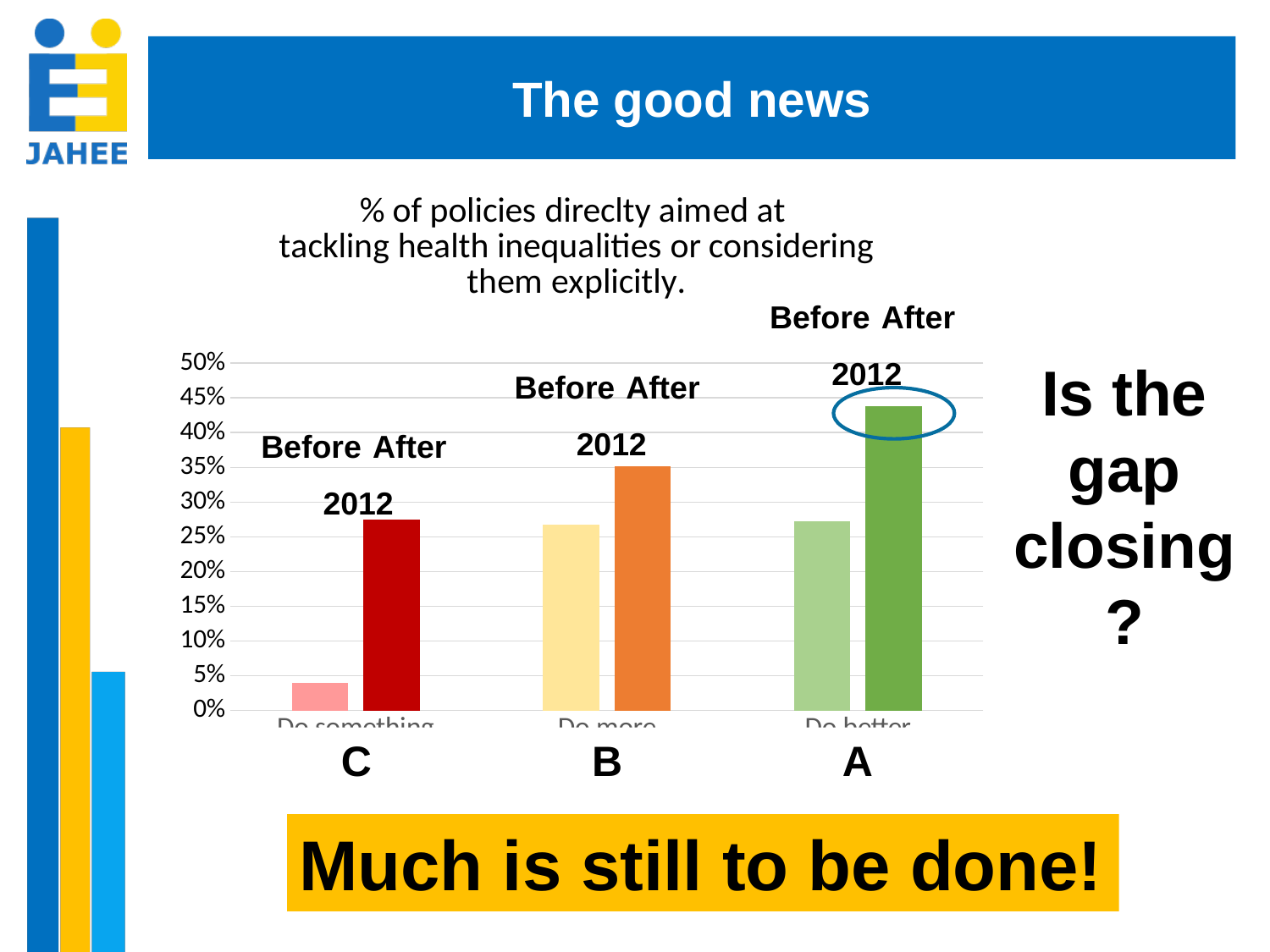
Is the After 2012 value for category B greater or less than 30%? greater Within each category group, does the value rise or fall from Before to After 2012? rise Is the Before 2012 value for category C greater or less than 10%? less Is the After 2012 value for category C greater or less than 25%? greater How many category groups (C, B, A) are shown on the x axis of the chart? 3 Which bar in the chart is the highest? A After 2012 What is the title of the chart? % of policies direclty aimed at tackling health inequalities or considering them explicitly. What kind of chart is shown on the slide? bar chart Which bar in the chart is the lowest? C Before 2012 Which is larger: the After 2012 value for category A or the After 2012 value for category B? A How many bars are plotted for each category group in the chart? 2